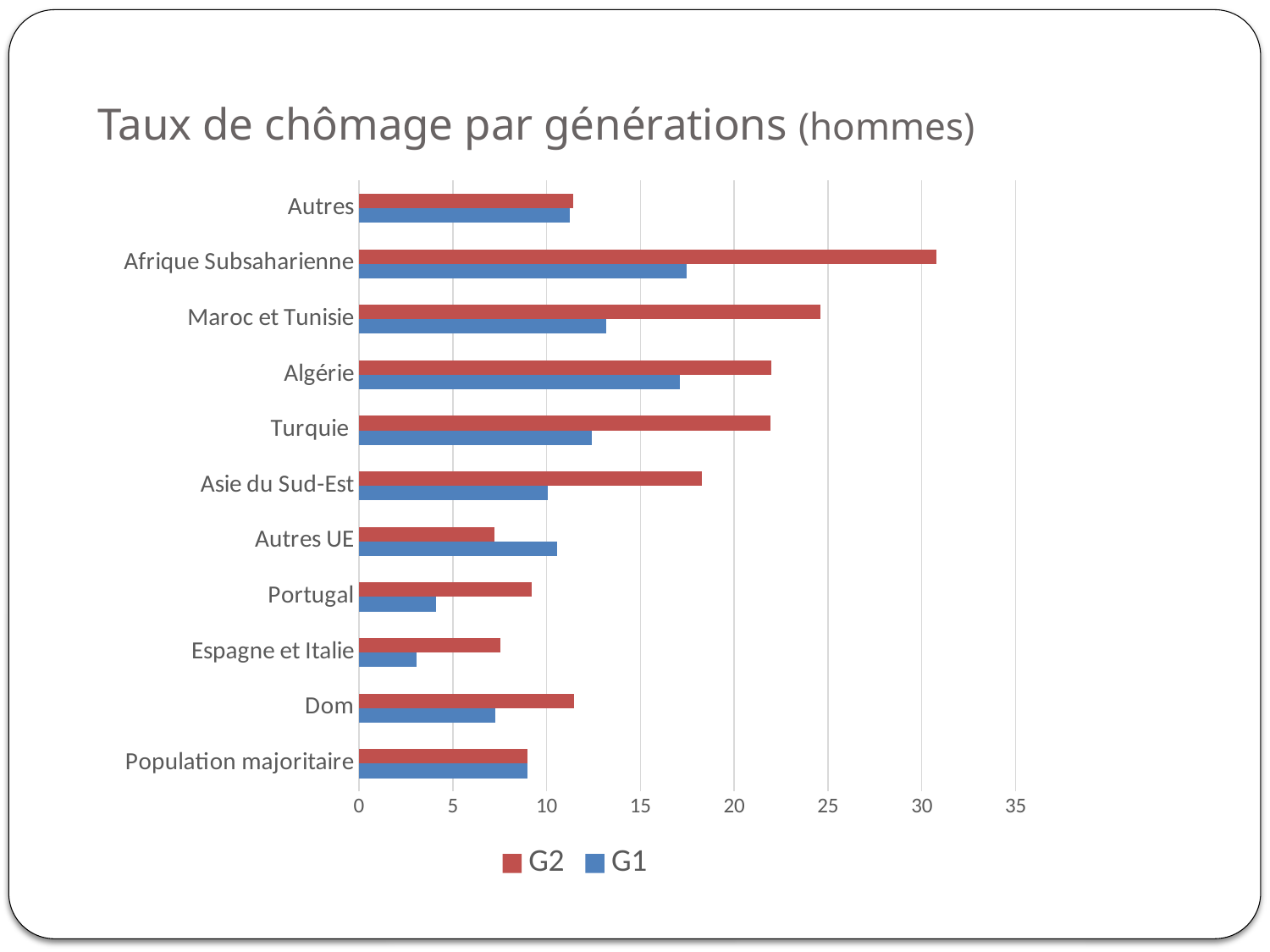
Which category has the highest G2 value? Afrique Subsaharienne Is the G2 value for Autres UE greater or less than 10? less What kind of chart is shown on the slide? Bar chart How many categories are shown on the chart? 11 What is the title of the chart? Taux de chômage par générations (hommes) For Autres UE, which series has the larger value, G1 or G2? G1 Which is larger: the G1 value for Afrique Subsaharienne or the G1 value for Maroc et Tunisie? Afrique Subsaharienne Which category has the lowest G1 value? Espagne et Italie Is the G1 value for Portugal greater or less than 5? less How many series does the legend list? 2 Is the G1 value for Turquie greater or less than 10? greater